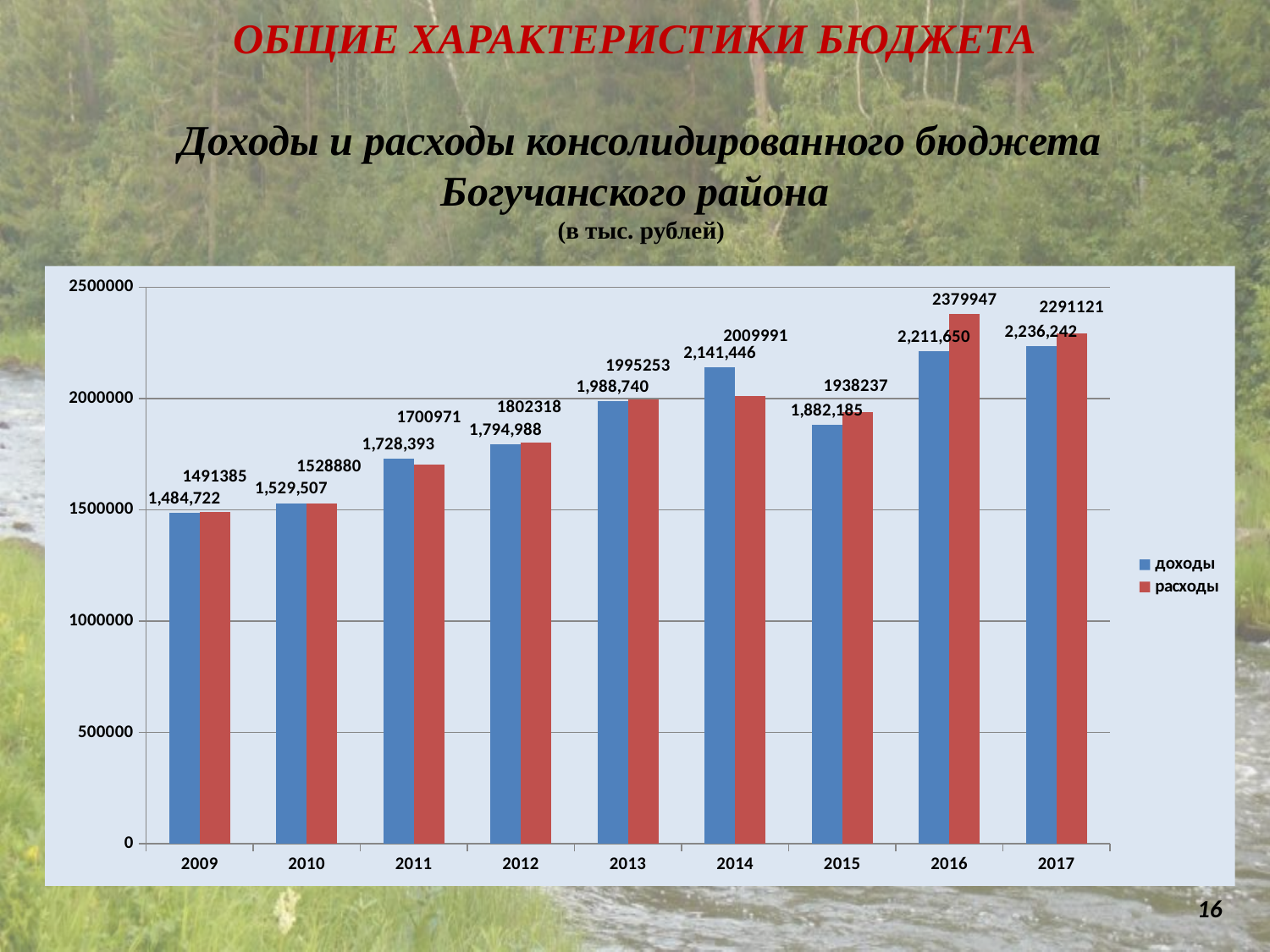
In which year is расходы the highest? 2016 What is the difference between расходы and доходы in 2016? 168297 What kind of chart is shown on the slide? bar chart In which year is доходы the lowest? 2009 What is the value of доходы for 2014? 2,141,446 How many series does the legend list? 2 What is the value of расходы for 2016? 2379947 In which year is доходы the highest? 2017 How many years are shown on the x axis? 9 In 2014, which is larger: доходы or расходы? доходы What is the value of расходы for 2009? 1491385 Is the value of доходы for 2015 greater or less than 2000000? less